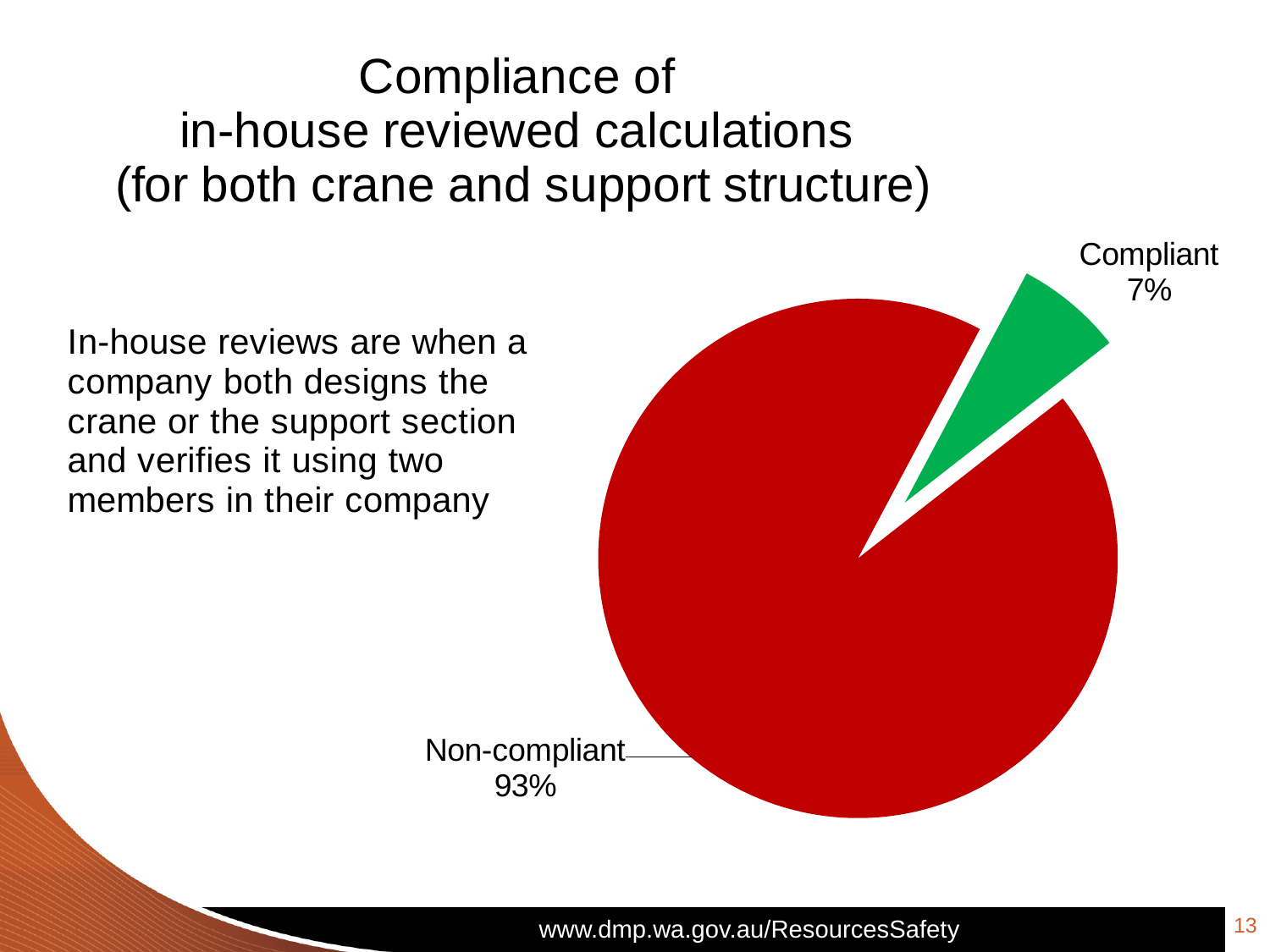
Which is larger, the Compliant slice or the Non-compliant slice? Non-compliant Is the Compliant share greater or less than 10%? less What is the difference in percentage points between the Non-compliant and Compliant slices? 86 What share of the pie is labelled Non-compliant? 93% What colour is the Compliant slice? Green What type of chart is shown on the slide? Pie chart Which slice of the pie is the largest? Non-compliant How many slices does the pie chart have? 2 Which slice of the pie is the smallest? Compliant What share of the pie is labelled Compliant? 7% What colour is the Non-compliant slice? Red